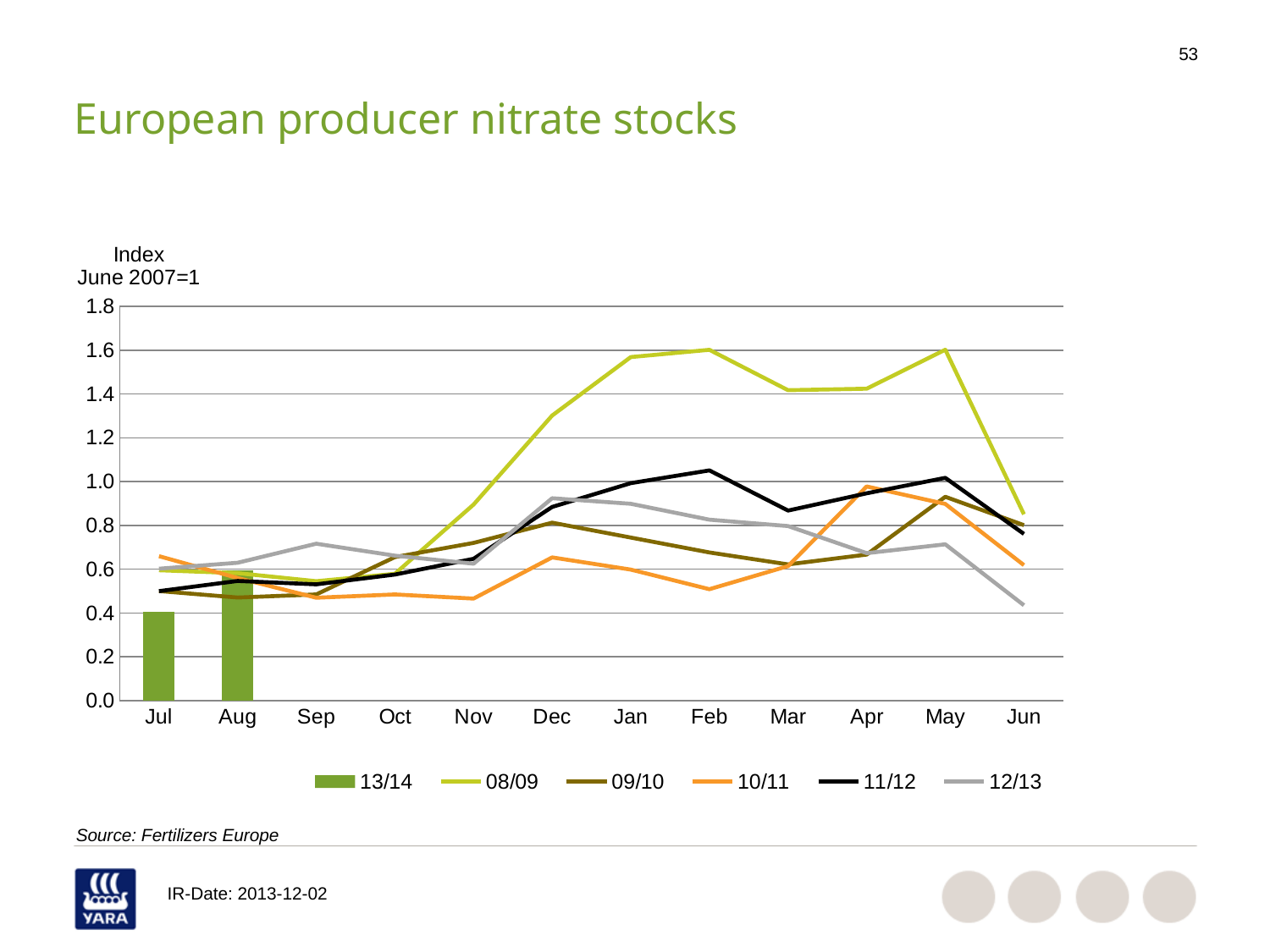
How many series does the legend list? 6 Which series reaches the highest index value on the chart? 08/09 Is the value for 08/09 in Feb greater or less than 1.4? greater Does the 08/09 line rise or fall from Sep to Jan? rise Is the value for 10/11 in Apr greater or less than 0.8? greater Is the value for 12/13 in Jun greater or less than 0.6? less What is the title of the chart on the slide? European producer nitrate stocks What kind of chart is shown on the slide? A combined bar and line chart In Jun, which series has the larger value, 08/09 or 12/13? 08/09 How many months are shown along the x axis? 12